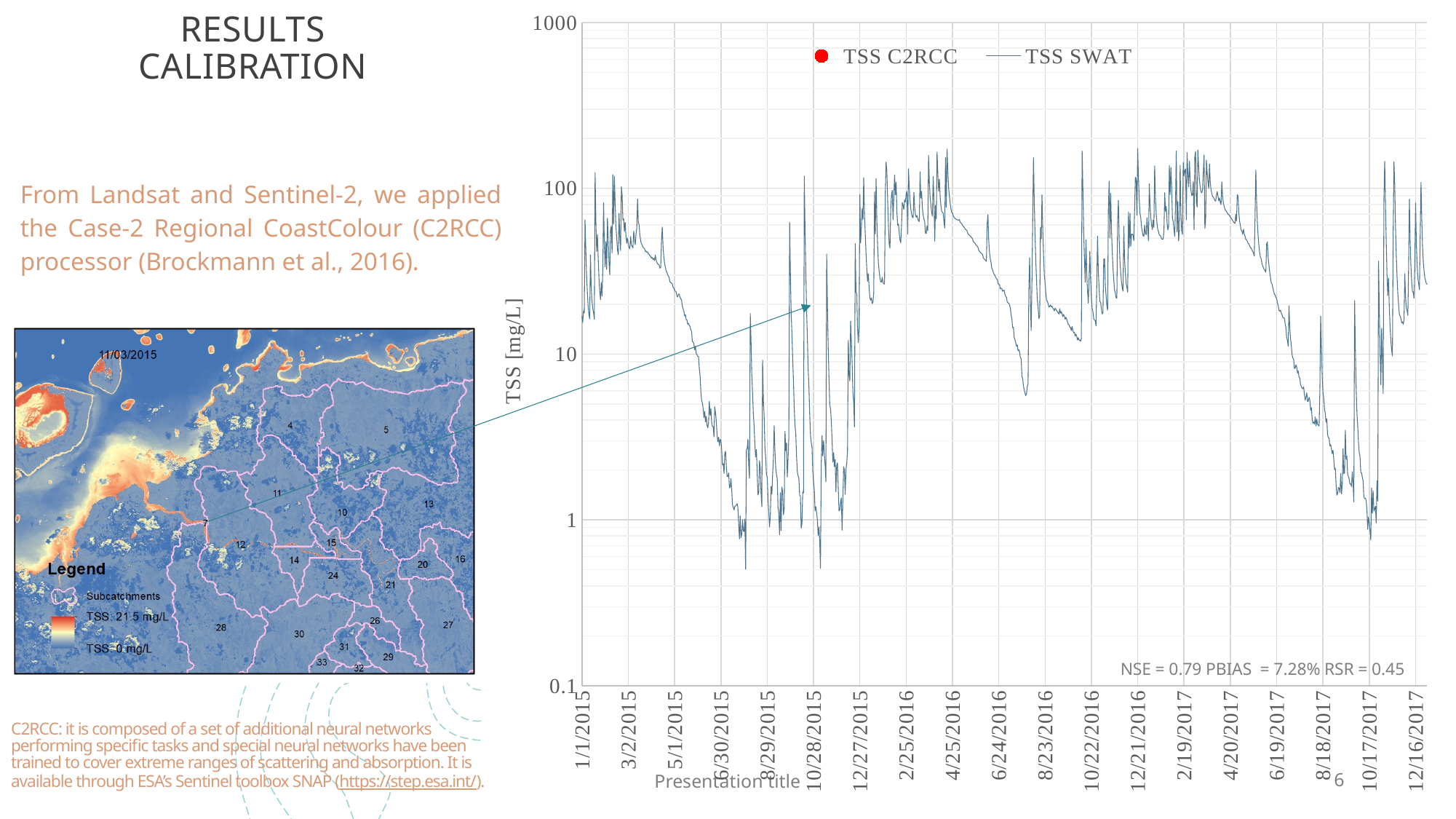
Is the highest value of the TSS SWAT series greater or less than 100? greater Is the highest value of the TSS SWAT series greater or less than 1000? less Is the lowest value of the TSS SWAT series greater or less than 1? less What is the label of the y-axis of the chart? TSS [mg/L] Does the TSS SWAT series generally rise or fall between 8/29/2015 and 12/27/2015? rise What NSE value is printed on the chart? 0.79 What kind of chart is shown on the slide? line chart Does the TSS SWAT series generally rise or fall between 1/1/2015 and 8/29/2015? fall How many series does the chart legend list? 2 How many date labels are shown on the x-axis of the chart? 19